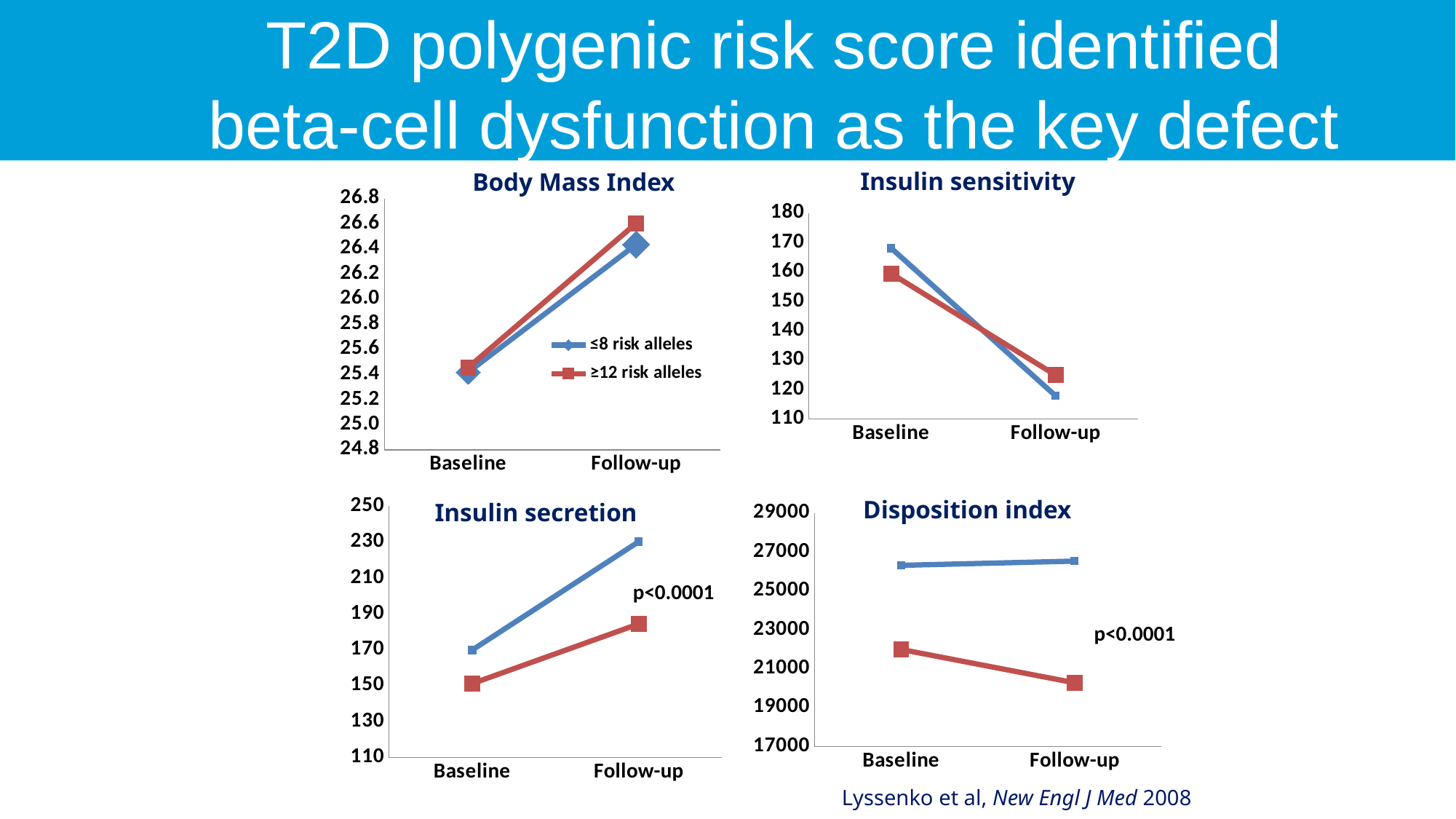
In the Insulin secretion chart, which series has the higher value at Follow-up, ≤8 risk alleles or ≥12 risk alleles? ≤8 risk alleles In the Insulin sensitivity chart, do the values rise or fall from Baseline to Follow-up? fall How many series does the legend on the Body Mass Index chart list? 2 In the Body Mass Index chart, is the Follow-up value for ≥12 risk alleles greater or less than 26.4? greater How many x-axis categories does the Insulin secretion chart have? 2 In the Insulin secretion chart, is the Follow-up value for ≤8 risk alleles greater or less than 210? greater What kind of chart is the Body Mass Index chart? line chart In the Disposition index chart, does the ≥12 risk alleles (red) series rise or fall from Baseline to Follow-up? fall In the Insulin sensitivity chart, is the Baseline value for ≤8 risk alleles greater or less than 160? greater What are the two series named in the legend of the Body Mass Index chart? ≤8 risk alleles and ≥12 risk alleles In the Body Mass Index chart, do the values rise or fall from Baseline to Follow-up? rise